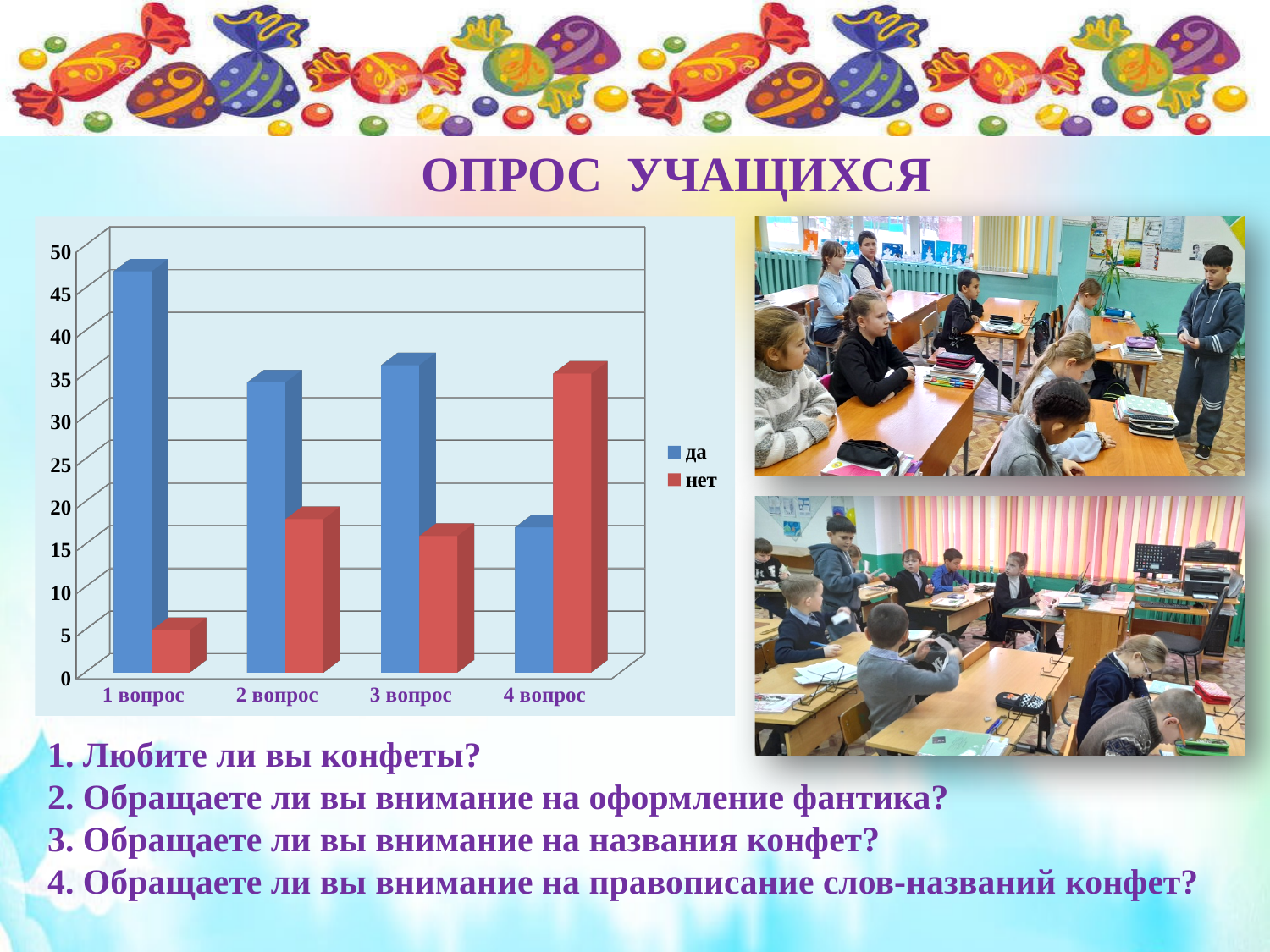
Which category has the highest value for the "да" series? 1 вопрос For 4 вопрос, which is larger: the "да" value or the "нет" value? нет Is the "нет" value for 1 вопрос greater or less than 10? less Is the "да" value for 4 вопрос greater or less than 20? less How many series does the chart legend list? 2 Which category has the lowest value for the "нет" series? 1 вопрос Which category has the highest value for the "нет" series? 4 вопрос What kind of chart is shown on the slide? bar chart Is the "да" value for 1 вопрос greater or less than 40? greater Which category has the lowest value for the "да" series? 4 вопрос What are the two entries in the chart legend? да, нет How many question categories are shown on the x axis of the chart? 4